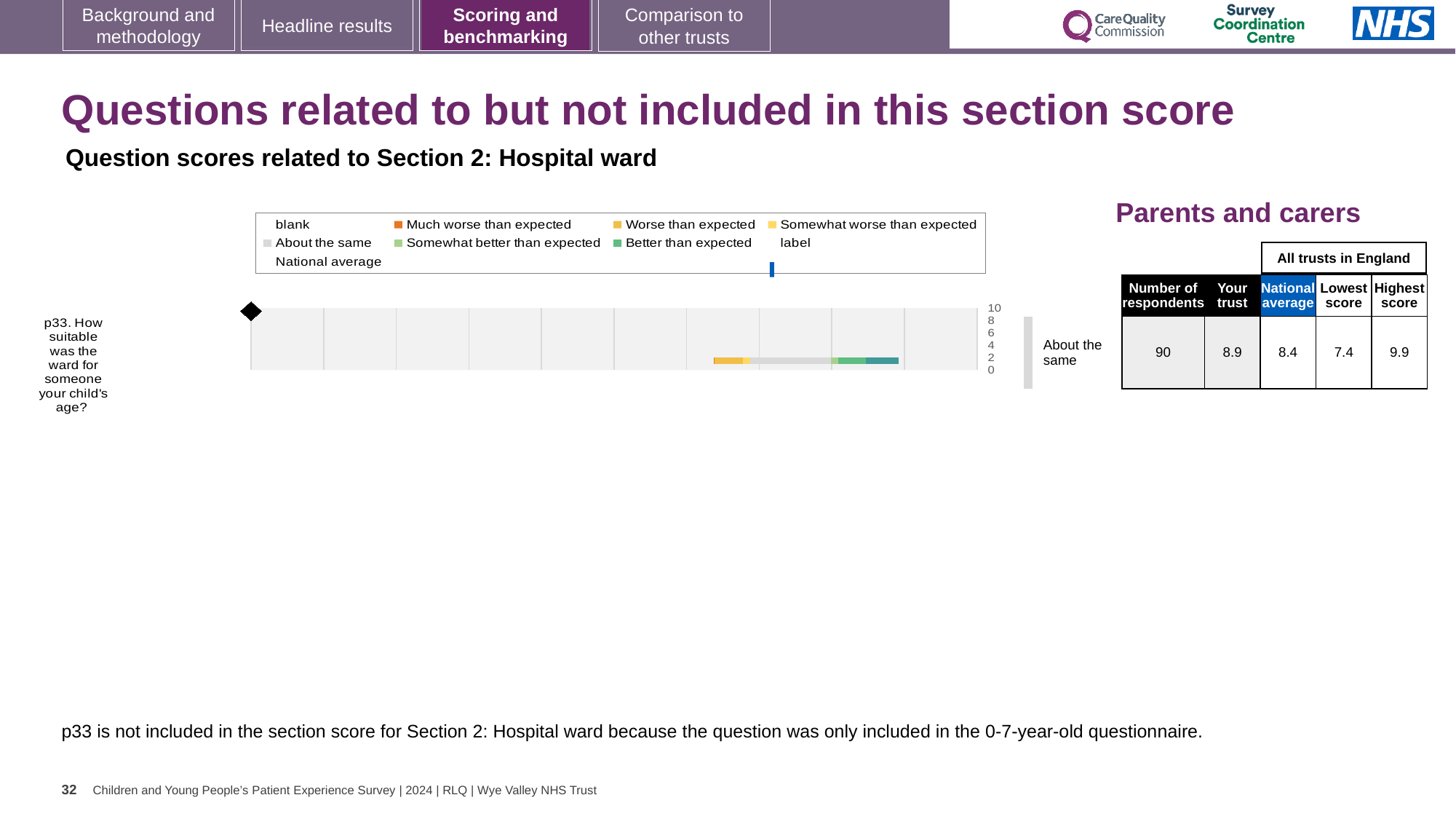
In the Parents and carers table, what is the lowest score among all trusts in England for p33? 7.4 Which is larger for p33: the 'Your trust' score or the national average? Your trust What is the question label shown on the left of the chart? p33. How suitable was the ward for someone your child's age? What benchmark category is shown to the right of the p33 bar? About the same In the Parents and carers table, what is the 'Your trust' score for p33? 8.9 In the Parents and carers table, what is the national average score for p33? 8.4 What is the difference between the 'Your trust' score and the national average for p33? 0.5 In the Parents and carers table, what is the highest score among all trusts in England for p33? 9.9 How many respondents are listed for p33 in the Parents and carers table? 90 What kind of chart is shown for question p33? bar chart How many questions (categories) are plotted in the chart? 1 What is the highest value shown on the chart's axis? 10